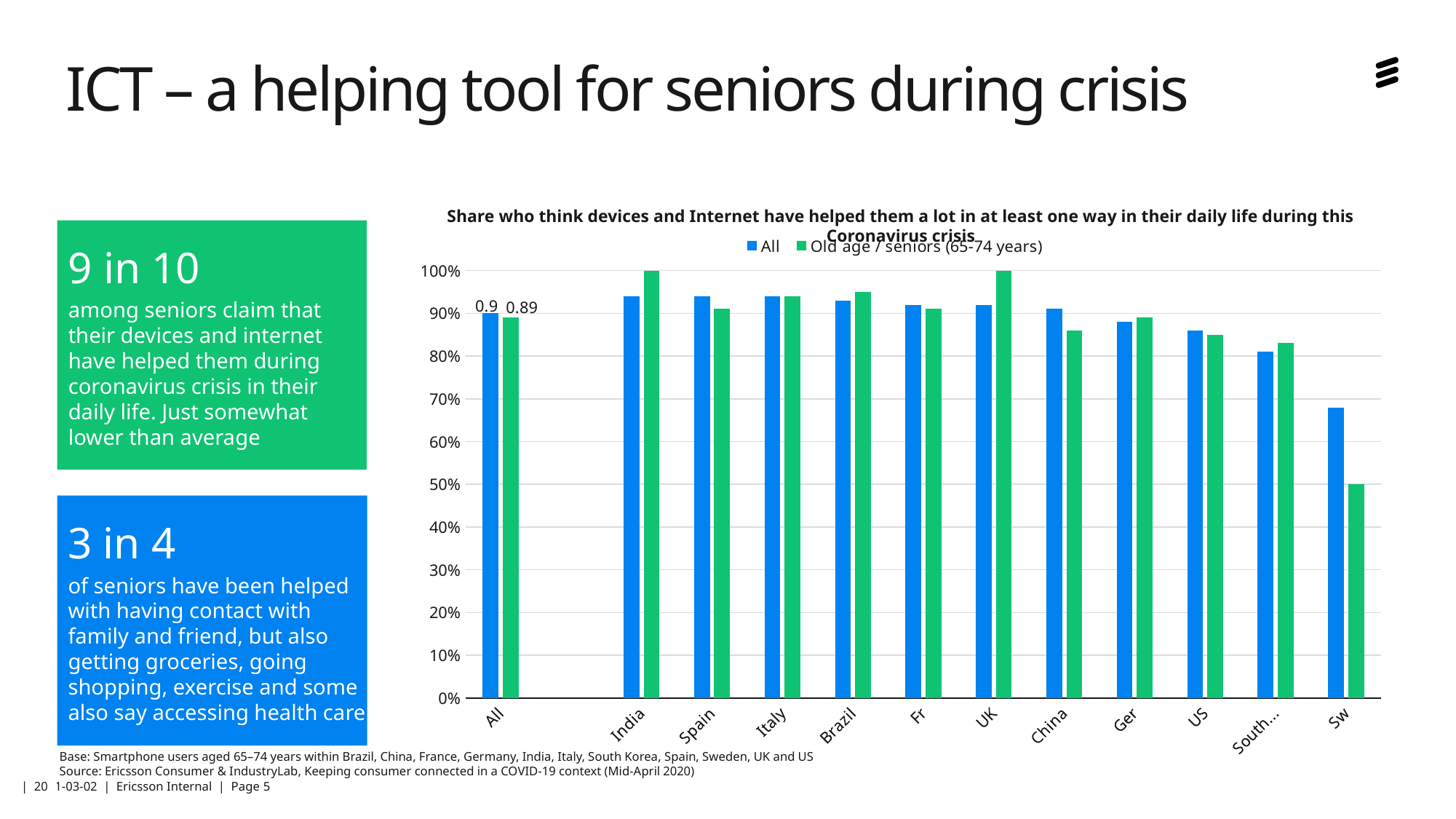
What kind of chart is shown on the slide? bar chart What is the difference between the 'All' and 'Old age / seniors (65-74 years)' values for the 'All' category? 0.01 What is the 'Old age / seniors (65-74 years)' value for India? 100% For Sw, which series has the larger value, 'All' or 'Old age / seniors (65-74 years)'? All What is the value of the 'Old age / seniors (65-74 years)' series for the 'All' category? 0.89 Which colour represents the 'Old age / seniors (65-74 years)' series? green What is the 'Old age / seniors (65-74 years)' value for Sw? 50% Which category has the lowest value for the 'Old age / seniors (65-74 years)' series? Sw Is the 'Old age / seniors (65-74 years)' value for China greater or less than 90%? less How many categories are shown on the x axis? 12 What is the value of the 'All' series for the 'All' category? 0.9 How many series does the legend list? 2